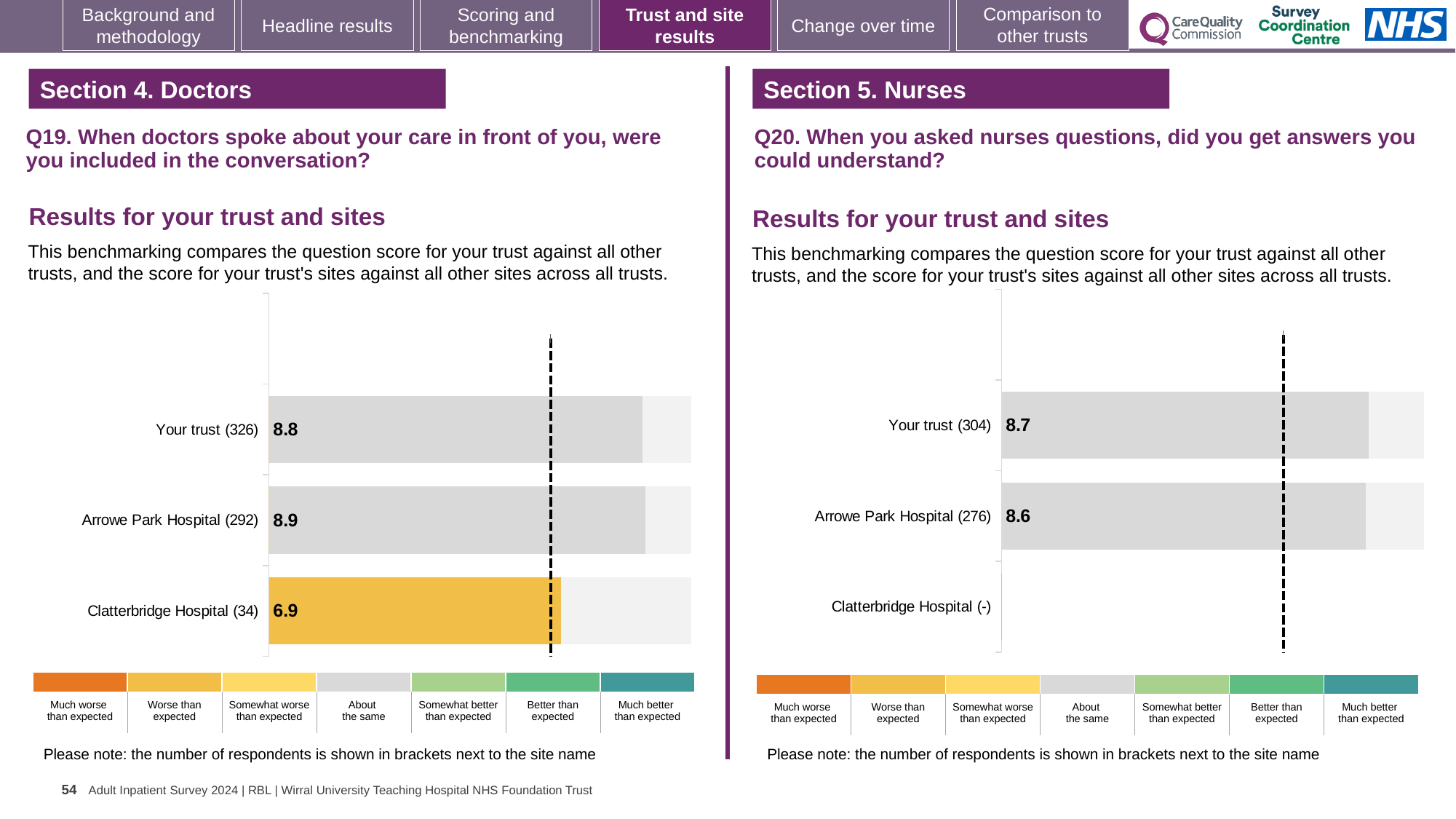
On the Q19 chart (left), which site has the lowest score? Clatterbridge Hospital On the Q19 chart (left), what is the score for Clatterbridge Hospital? 6.9 On the Q20 chart (right), how many sites or rows are listed? 3 On the Q19 chart (left), how many respondents are shown for Clatterbridge Hospital? 34 On the Q19 chart (left), which bar is coloured differently from the others? Clatterbridge Hospital What kind of chart is used on the Q19 chart (left)? Bar chart On the Q20 chart (right), what is the difference between the scores for Your trust and Arrowe Park Hospital? 0.1 On the Q20 chart (right), what is the score for Arrowe Park Hospital? 8.6 On the Q19 chart (left), what is the difference between the scores for Arrowe Park Hospital and Clatterbridge Hospital? 2.0 On the Q20 chart (right), how many respondents are shown for Your trust? 304 On the Q19 chart (left), what is the score for Your trust? 8.8 On the Q20 chart (right), what is the score for Your trust? 8.7